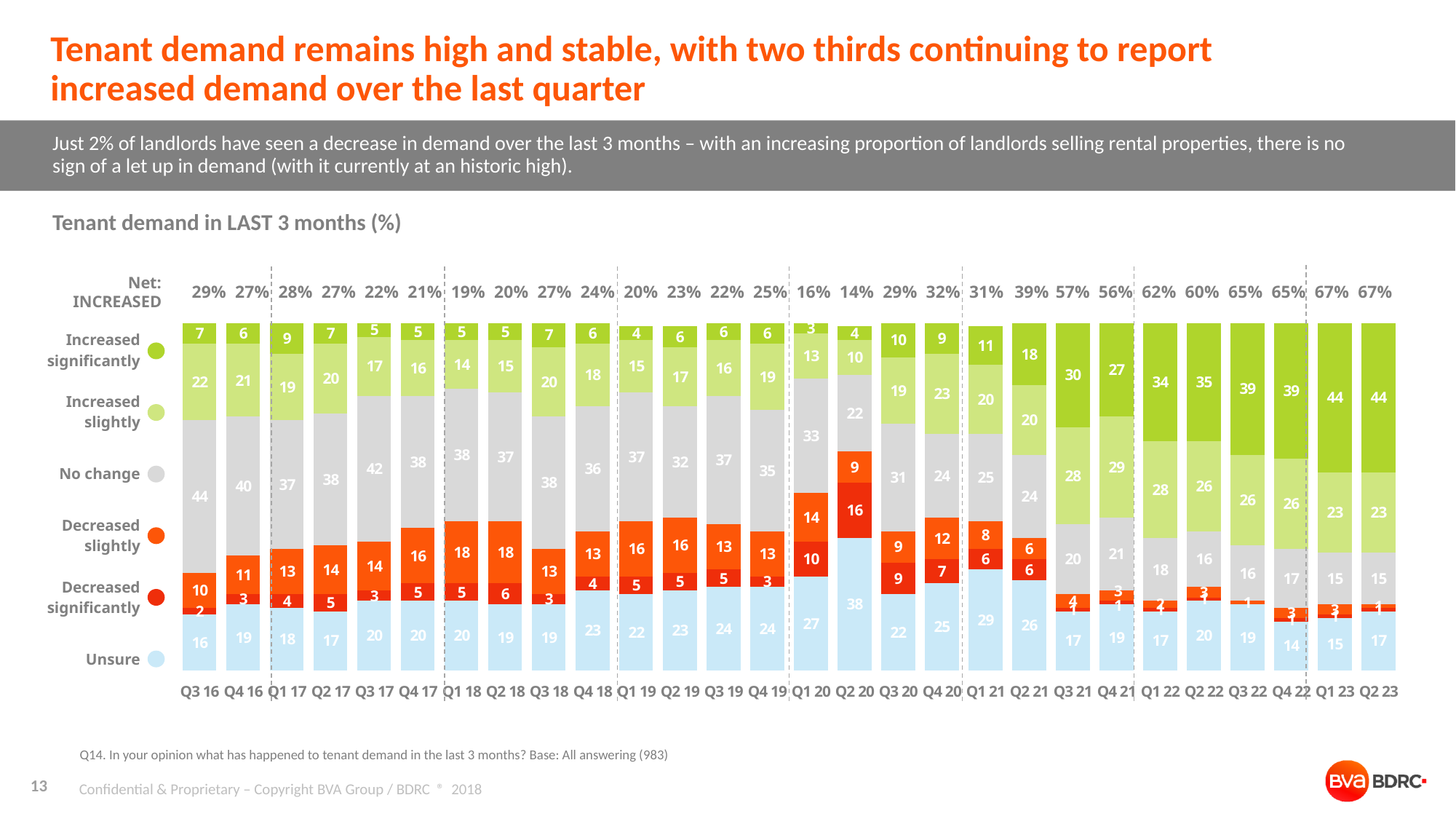
Which quarter has the highest 'No change' value? Q3 16 How many quarters are plotted along the x axis? 28 Which quarter has the lowest Net: INCREASED value? Q2 20 How many series does the legend list? 6 What kind of chart is shown on the slide? Stacked bar chart Does the Net: INCREASED value generally rise or fall from Q1 21 to Q2 23? Rise What is the 'Increased significantly' value for Q2 23? 44 What is the Net: INCREASED value for Q2 23? 67% Which quarter has the highest 'Decreased significantly' value? Q2 20 What is the 'Unsure' value for Q2 20? 38 What is the difference between the 'Increased significantly' values for Q2 23 and Q3 16? 37 Which is larger, the 'No change' value for Q3 16 or for Q2 23? Q3 16